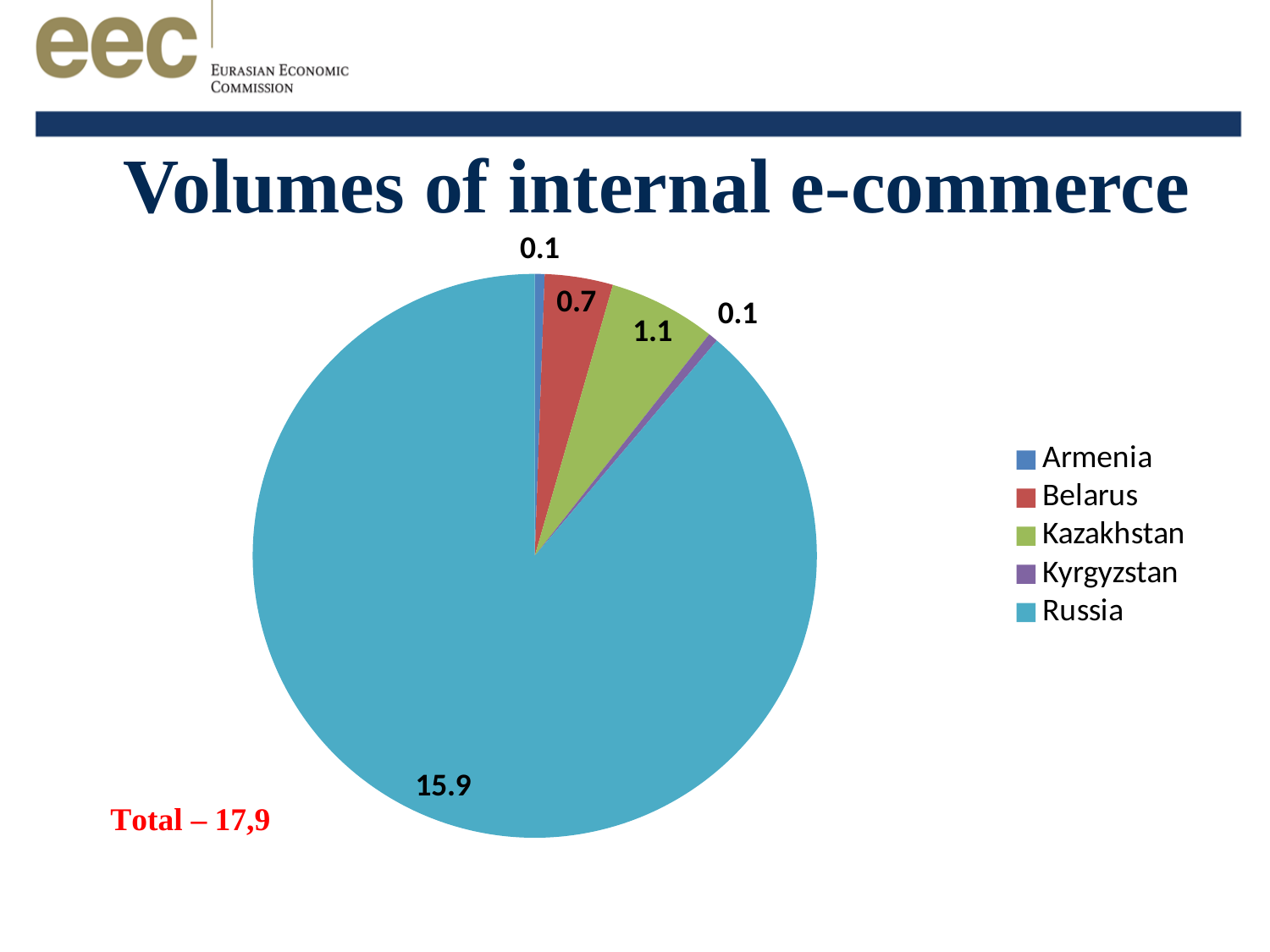
What is the value for Armenia in the pie chart? 0.1 What is the difference between the values for Russia and Kazakhstan? 14.8 What total is stated on the slide for the pie chart? 17,9 What type of chart is shown on the slide? Pie chart What is the value for Belarus in the pie chart? 0.7 What is the title of the slide containing the pie chart? Volumes of internal e-commerce What is the value for Russia in the pie chart? 15.9 What is the difference between the values for Kazakhstan and Belarus? 0.4 What is the value for Kazakhstan in the pie chart? 1.1 Which country has the largest slice of the pie chart? Russia How many countries are shown in the pie chart legend? 5 Which is larger, the value for Belarus or the value for Kazakhstan? Kazakhstan